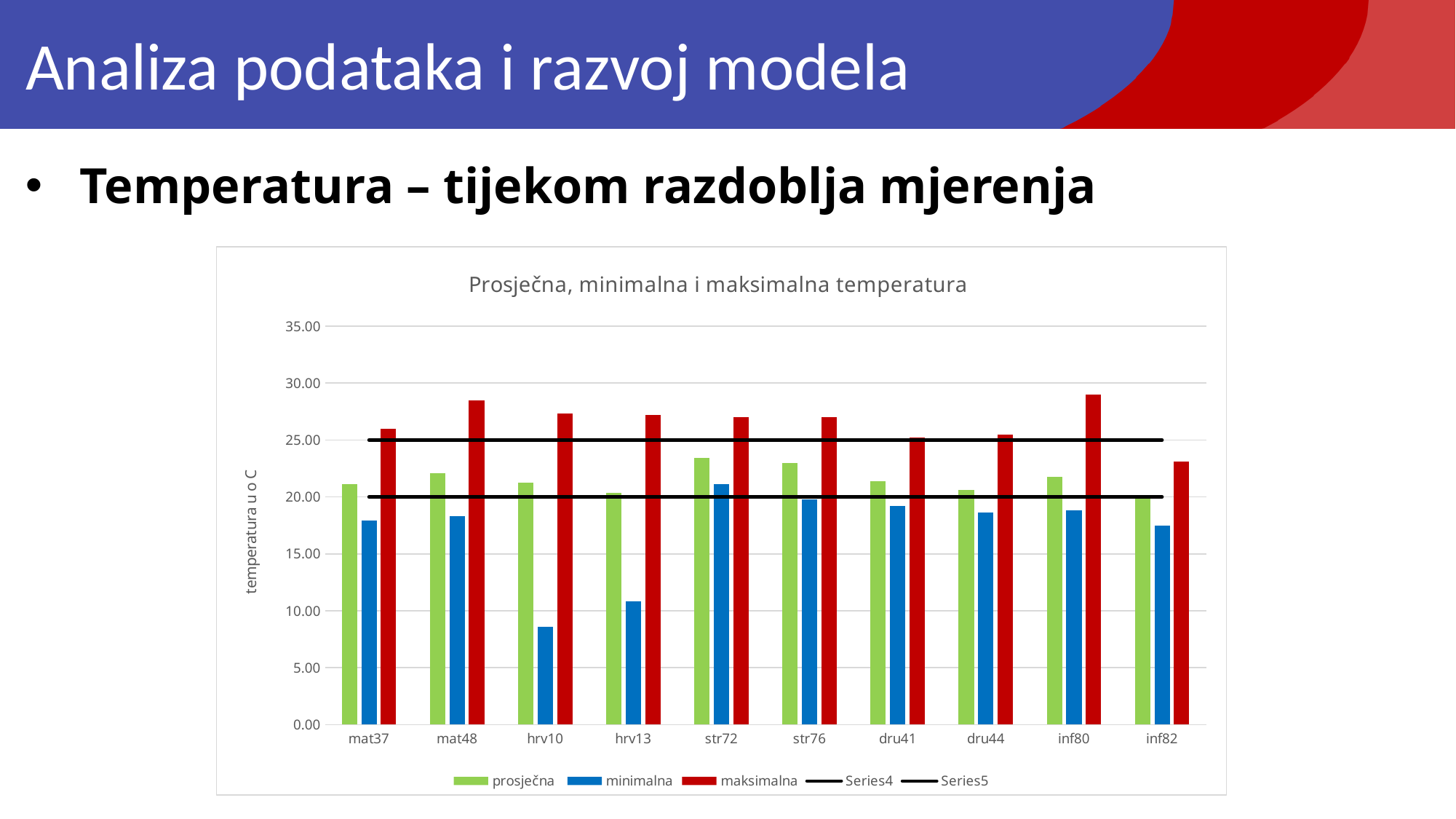
What kind of chart is shown on the slide? combination bar and line chart Which is larger, the maksimalna value for mat48 or for inf82? mat48 Which category has the lowest maksimalna value? inf82 How many series does the chart's legend list? 5 Is the minimalna value for str72 greater or less than 20.00? greater What is the title of the chart? Prosječna, minimalna i maksimalna temperatura How many categories are shown on the x axis of the chart? 10 Which is larger, the minimalna value for hrv10 or for hrv13? hrv13 Is the maksimalna value for inf82 greater or less than 25.00? less Is the maksimalna value for inf80 greater or less than 25.00? greater Which category has the lowest minimalna value? hrv10